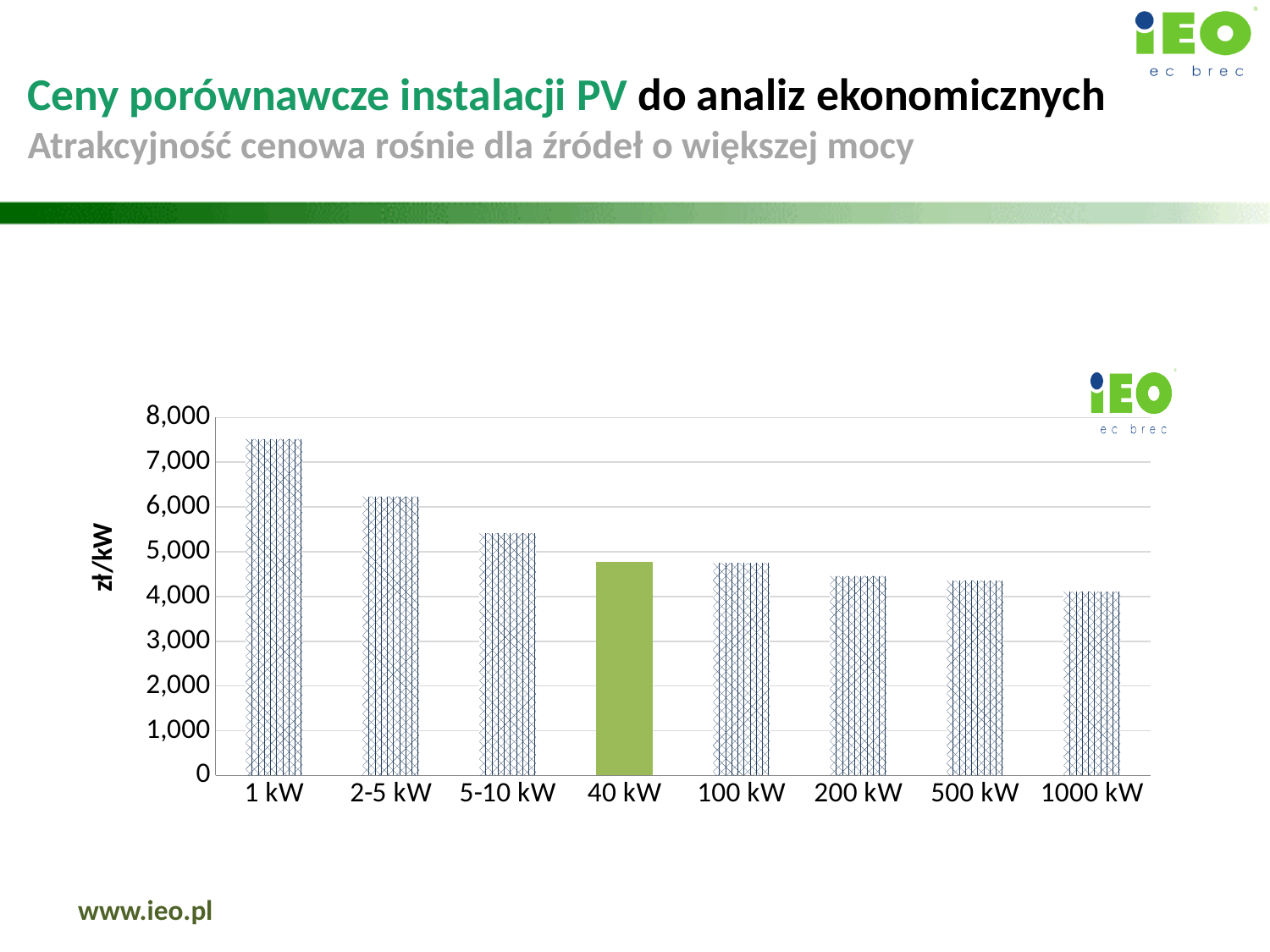
Which is larger, the value for 5-10 kW or the value for 100 kW? 5-10 kW Is the value for 200 kW greater or less than 4,000? greater How many categories are shown on the x axis of the chart? 8 Is the value for 2-5 kW greater or less than 6,000? greater Is the value for 1 kW greater or less than 7,000? greater Which category's bar is drawn in solid green rather than the hatched pattern? 40 kW Do the values rise or fall as you move from 1 kW to 1000 kW along the x axis? fall What is the label on the vertical axis of the chart? zł/kW Which category has the highest value in the chart? 1 kW What kind of chart is shown on the slide? bar chart Which category has the lowest value in the chart? 1000 kW